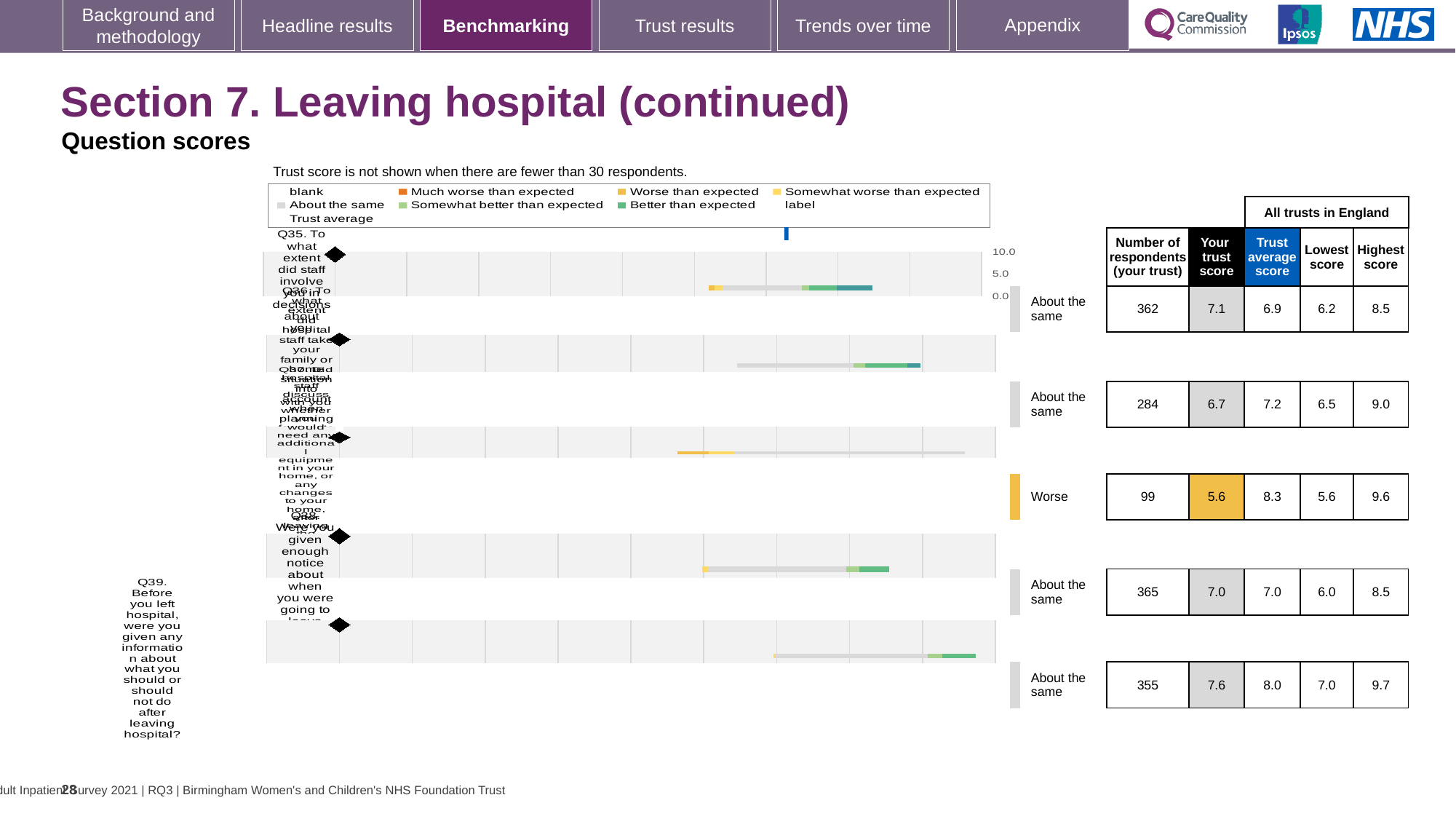
How many questions are shown in the benchmarking chart on this slide? 5 What is the trust average score for Q38 (given enough notice about when you were going to leave)? 7.0 What is the trust score for Q39 (information about what you should or should not do after leaving hospital)? 7.6 For Q35, is this trust's score higher or lower than the trust average score? Higher What is the difference between the trust average score and this trust's score for Q39? 0.4 Which question has the highest 'Your trust score' on this slide? Q39 How many questions on this slide are rated 'Worse' than expected? 1 How many respondents answered Q35 (staff involving you in decisions about leaving hospital) at this trust? 362 What kind of chart is used to show the benchmarking results? Bar chart Which question has the lowest 'Your trust score' on this slide? The third question (trust score 5.6) What is the highest score across all trusts in England for Q39? 9.7 What is the lowest score across all trusts in England for Q38? 6.0